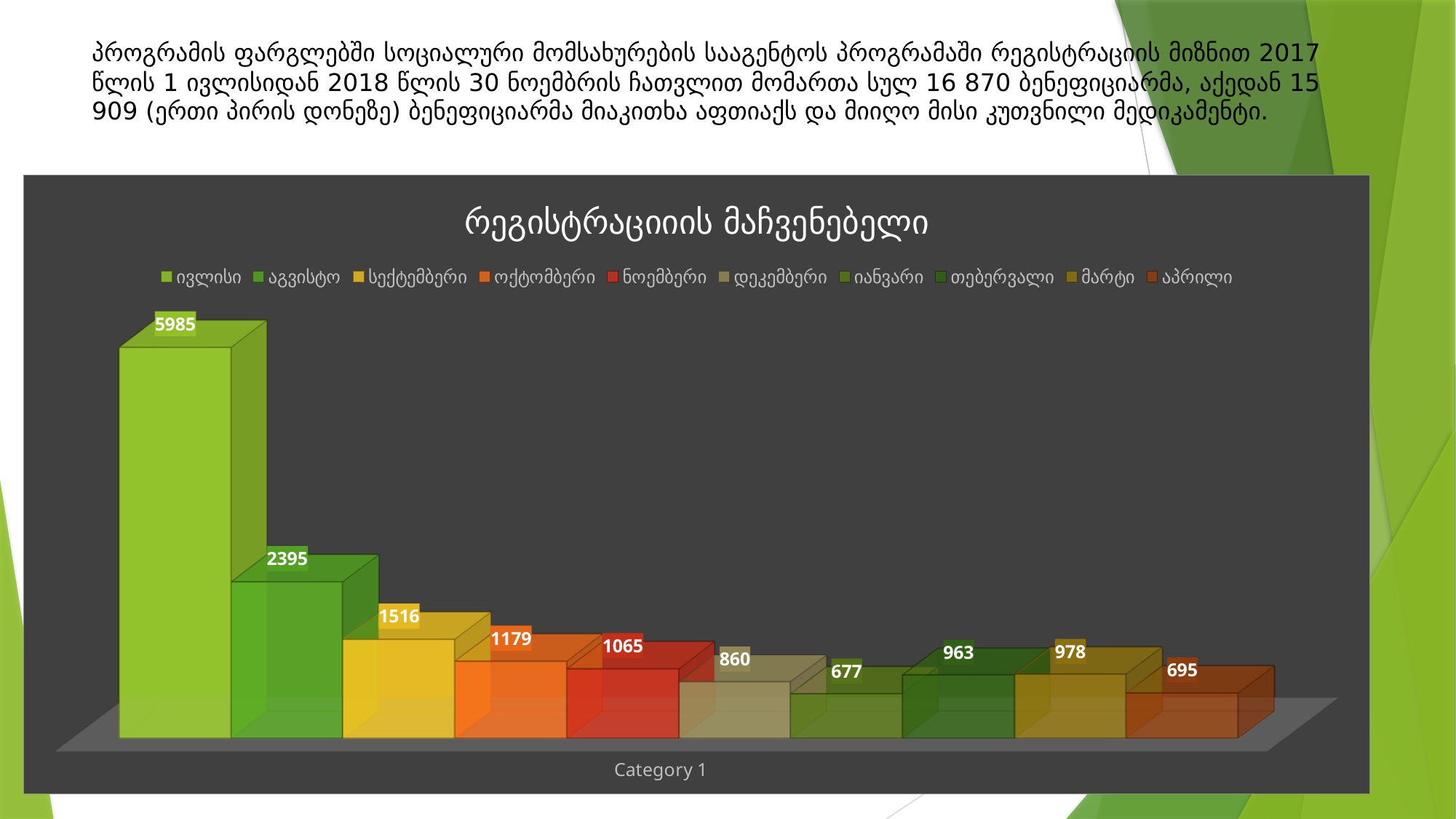
Which series has the lowest value? იანვარი What is the value for დეკემბერი? 860 How many series does the chart legend list? 10 Which is larger, the value for თებერვალი or the value for აპრილი? თებერვალი What is the difference between the values for სექტემბერი and ოქტომბერი? 337 What is the value for მარტი? 978 Which series has the highest value? ივლისი What is the title of the chart? რეგისტრაციიის მაჩვენებელი What is the value for აგვისტო? 2395 What is the value for ივლისი? 5985 What is the difference between the values for ივლისი and აგვისტო? 3590 What type of chart is shown on the slide? bar chart